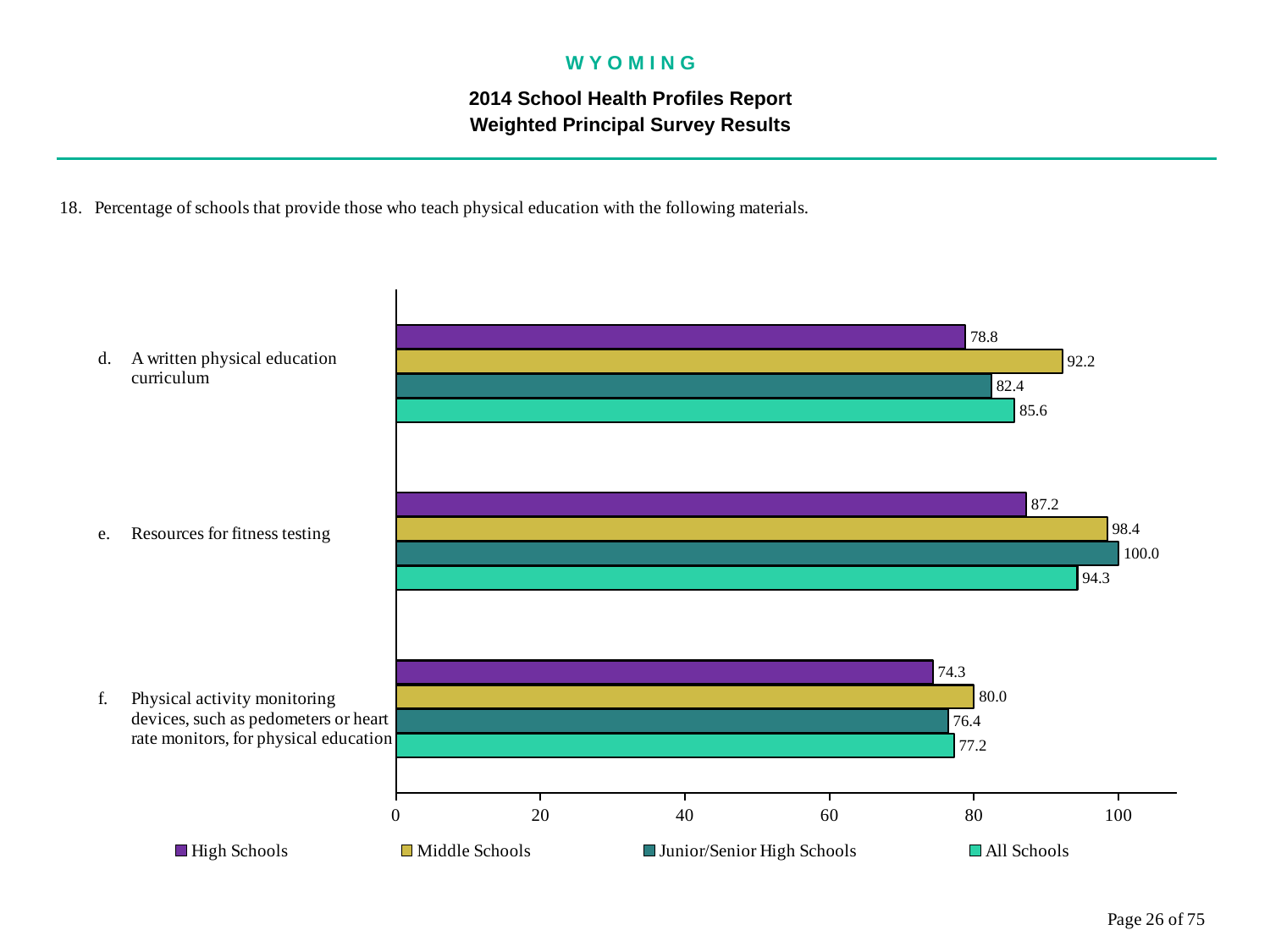
How many materials (categories) are shown on the chart? 3 What percentage of Middle Schools provide a written physical education curriculum? 92.2 What is the value for Junior/Senior High Schools for resources for fitness testing? 100.0 Which school type has the highest value for resources for fitness testing? Junior/Senior High Schools Which series is shown in purple in the legend? High Schools What kind of chart is shown on the slide? bar chart How many series does the legend list? 4 Which school type has the lowest value for physical activity monitoring devices? High Schools What is the difference between the Middle Schools and High Schools values for a written physical education curriculum? 13.4 What is the All Schools value for physical activity monitoring devices, such as pedometers or heart rate monitors, for physical education? 77.2 Is the High Schools value for resources for fitness testing greater or less than 80? greater Which is larger for a written physical education curriculum: the All Schools value or the Junior/Senior High Schools value? All Schools